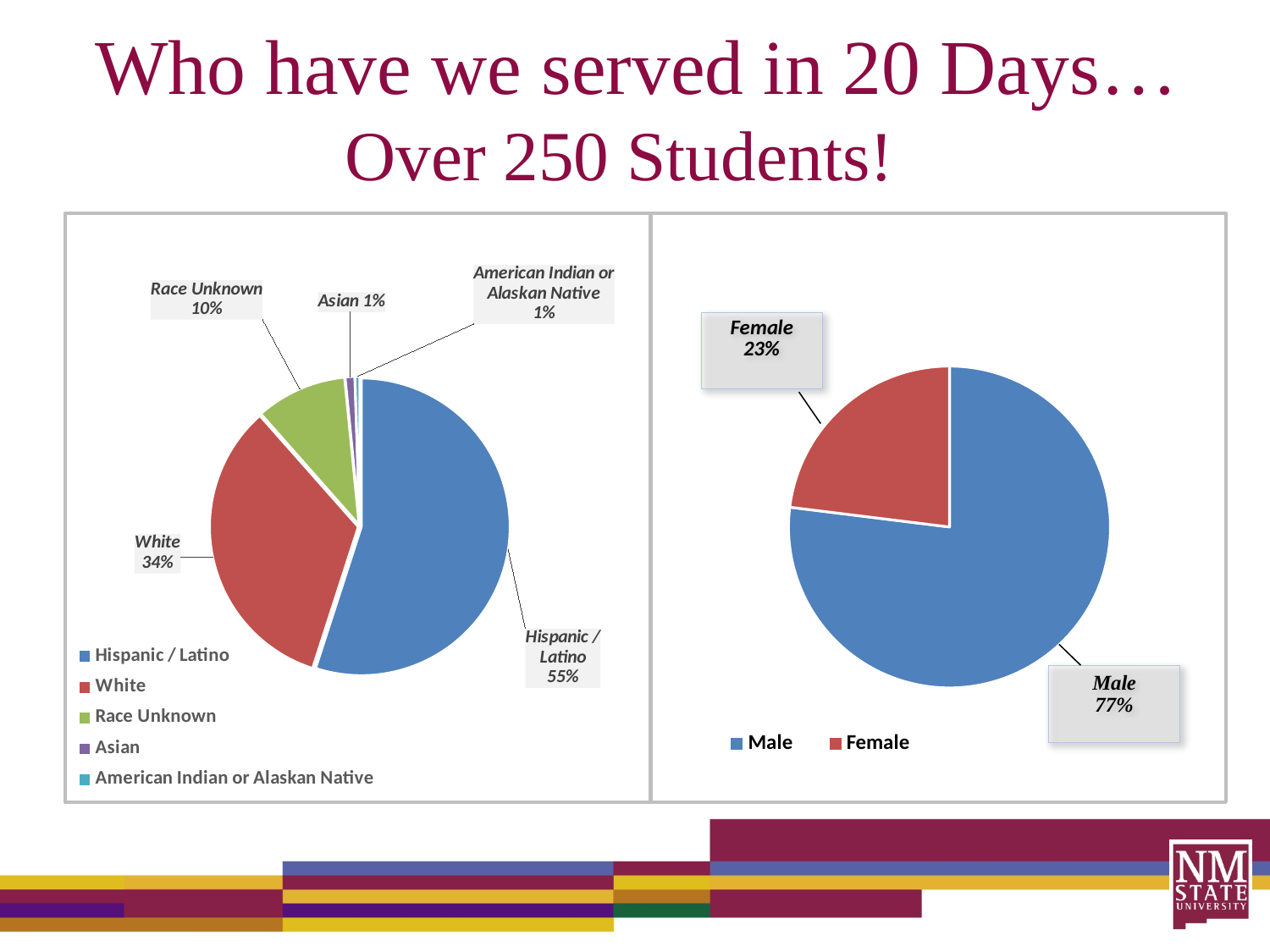
In the left pie chart, what is the difference in percentage points between Hispanic / Latino and White? 21 In the left pie chart, what colour is the Race Unknown slice? Green In the left pie chart, what share of students is Race Unknown? 10% What kind of chart is the right chart? Pie chart In the left pie chart, what share of students is White? 34% In the left pie chart, which category has the largest share? Hispanic / Latino In the left pie chart, what share of students is Hispanic / Latino? 55% In the right pie chart, what share of students is Male? 77% In the right pie chart, what share of students is Female? 23% How many categories does the legend of the left pie chart list? 5 In the left pie chart, which is larger, the White share or the Race Unknown share? White In the right pie chart, what is the difference in percentage points between Male and Female? 54